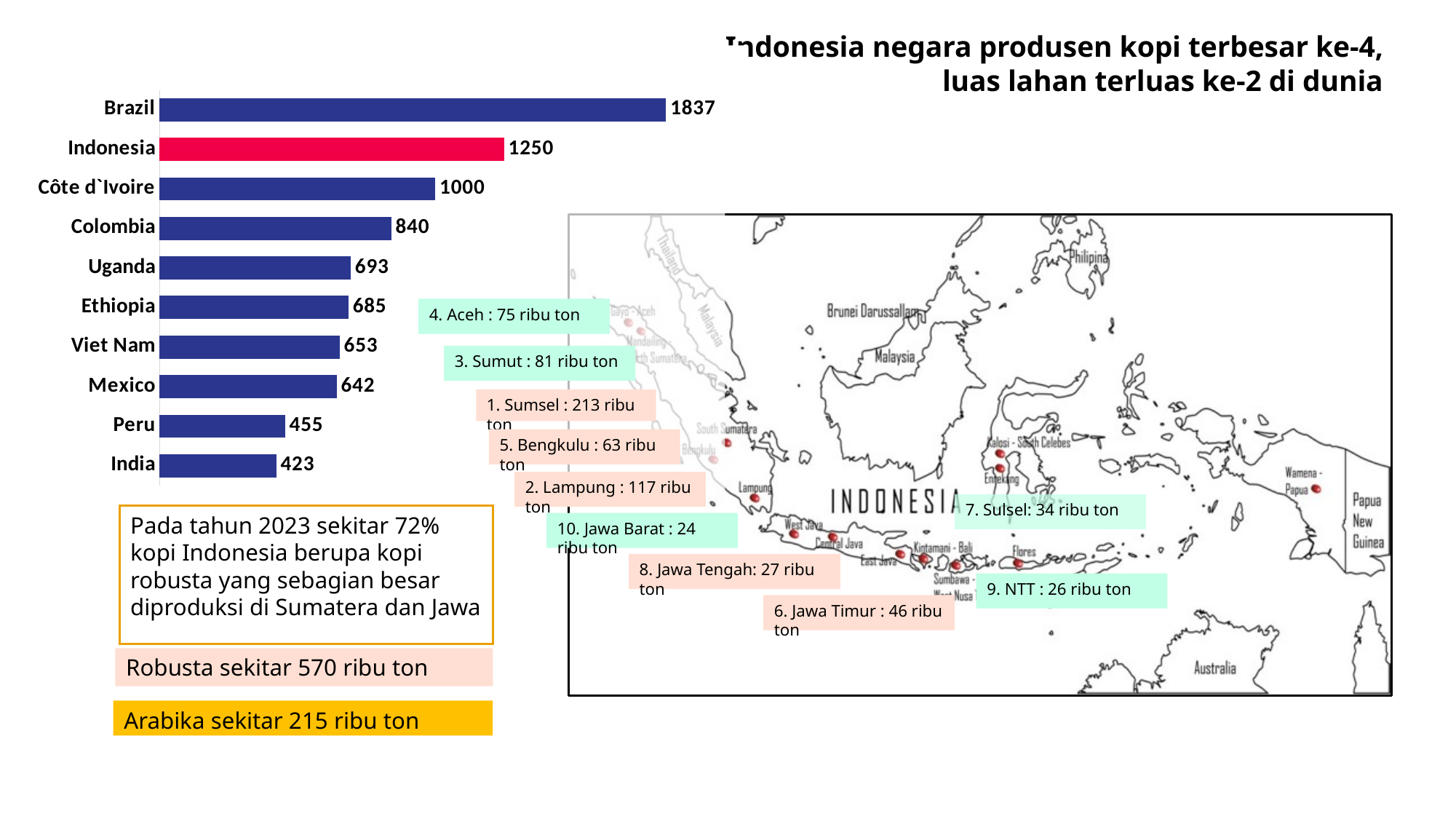
Which country has the highest value in the bar chart? Brazil What is the difference between the values for Peru and India? 32 What is the value shown for Brazil? 1837 What is the value shown for Colombia? 840 What is the value shown for Viet Nam? 653 Which has a larger value, Colombia or Peru? Colombia What is the difference between the values for Brazil and Indonesia? 587 Which country's bar is coloured differently (red) from the other bars? Indonesia What type of chart is shown on the left of the slide? bar chart How many countries are shown in the bar chart? 10 Which country has the lowest value in the bar chart? India What is the value shown for Indonesia? 1250